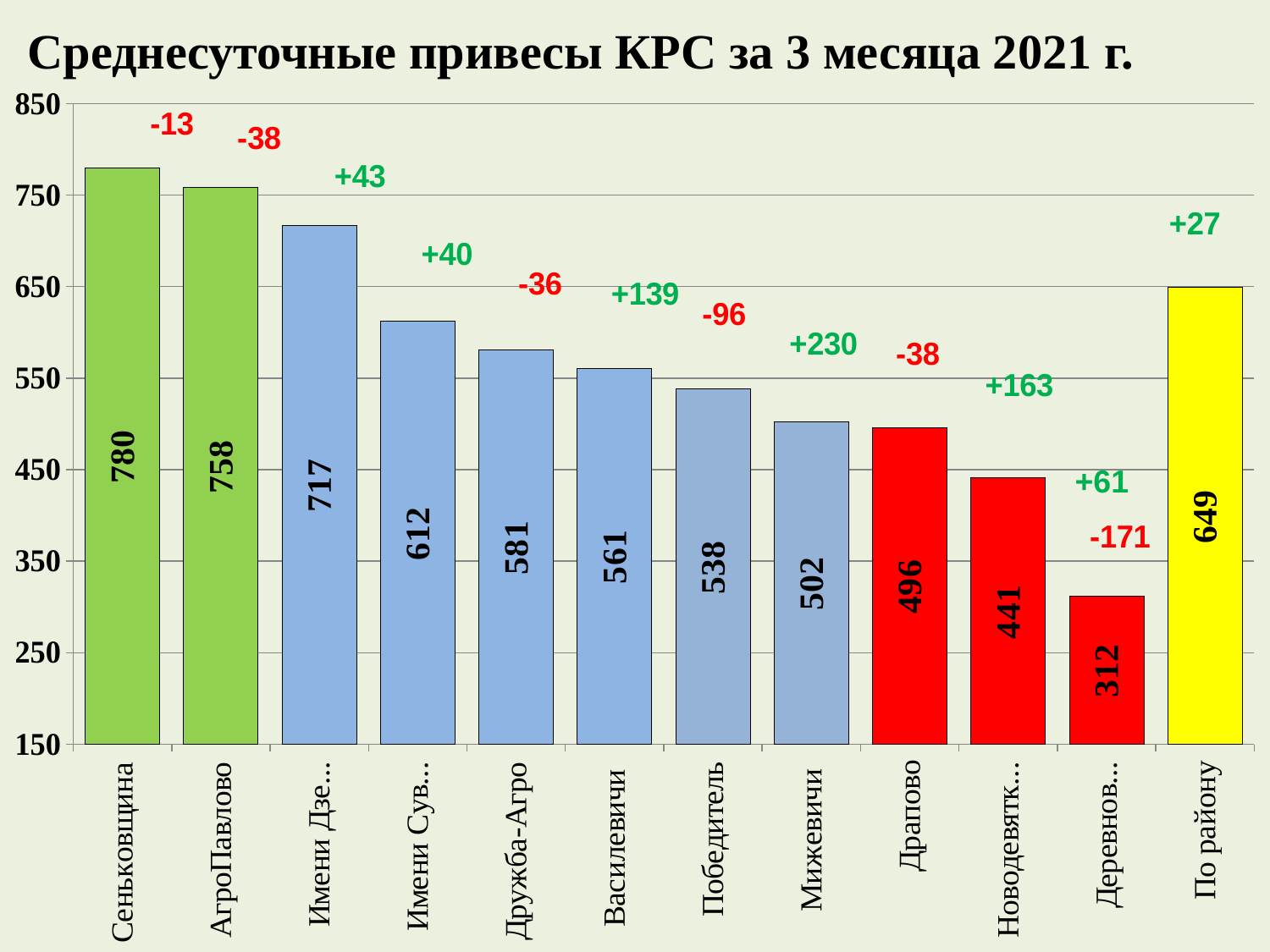
What is the value for Драпово? 496 What colour is the bar for По району? yellow What is the lowest value shown in the chart? 312 What kind of chart is shown on the slide? bar chart What is the difference between the values for Сеньковщина and АгроПавлово? 22 Which category has the highest value? Сеньковщина What is the title of the chart? Среднесуточные привесы КРС за 3 месяца 2021 г. Which is larger, the value for Василевичи or the value for Победитель? Василевичи What is the value for Сеньковщина? 780 How many bars are plotted in the chart? 12 What is the value for По району? 649 Is the value for Мижевичи greater or less than 550? less